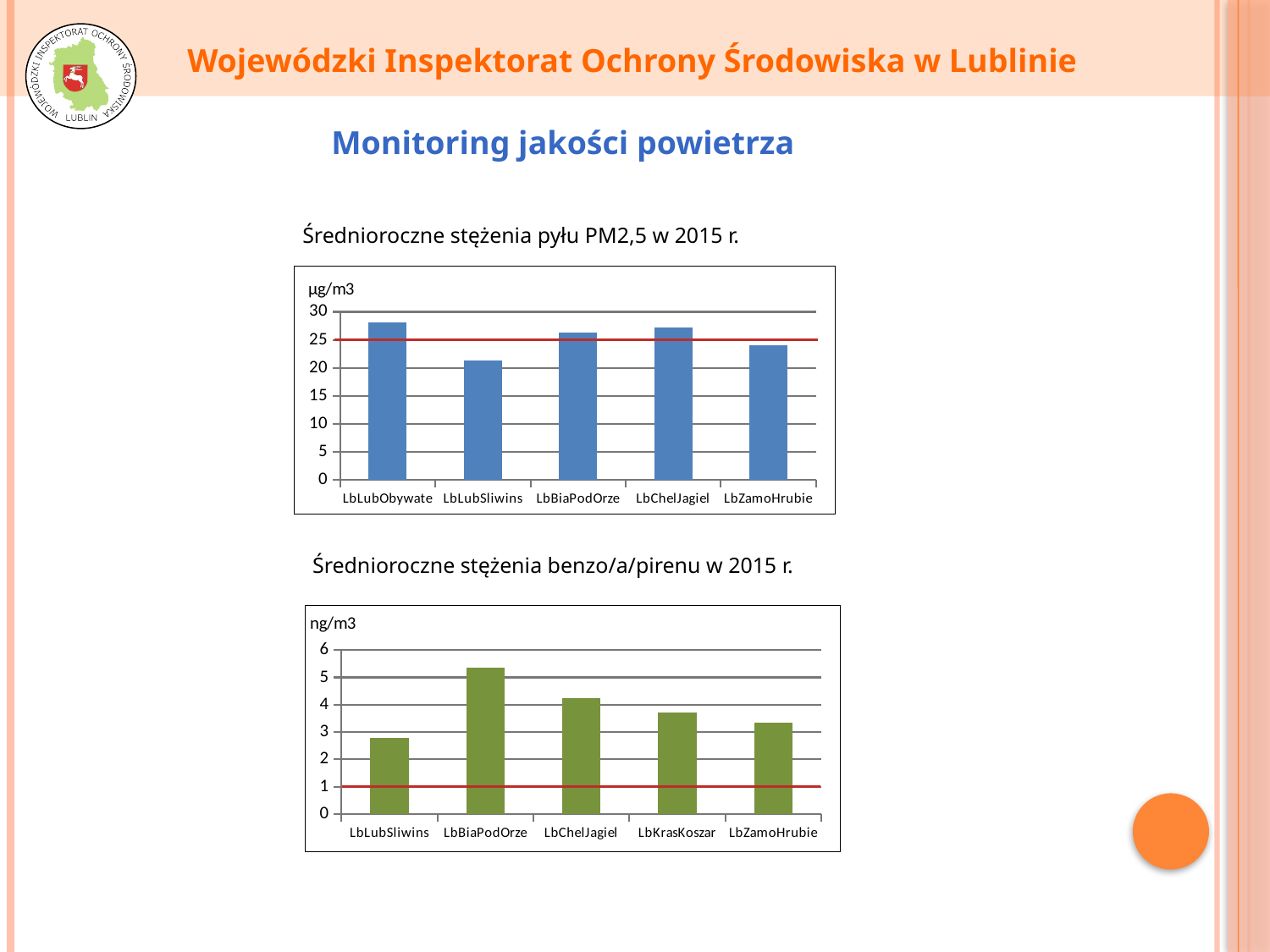
In the chart 'Średnioroczne stężenia pyłu PM2,5 w 2015 r.', which station has the lowest value? LbLubSliwins In the chart 'Średnioroczne stężenia pyłu PM2,5 w 2015 r.', is the value for LbZamoHrubie greater or less than 25? less How many stations are shown in the chart 'Średnioroczne stężenia pyłu PM2,5 w 2015 r.'? 5 In the chart 'Średnioroczne stężenia benzo/a/pirenu w 2015 r.', is the value for LbLubSliwins greater or less than 3? less In the chart 'Średnioroczne stężenia benzo/a/pirenu w 2015 r.', is the value for LbBiaPodOrze greater or less than 5? greater What unit is shown on the y axis of the chart 'Średnioroczne stężenia pyłu PM2,5 w 2015 r.'? µg/m3 In the chart 'Średnioroczne stężenia benzo/a/pirenu w 2015 r.', which station has the highest value? LbBiaPodOrze In the chart 'Średnioroczne stężenia pyłu PM2,5 w 2015 r.', which is larger, the value for LbLubObywate or LbLubSliwins? LbLubObywate What type of chart is 'Średnioroczne stężenia benzo/a/pirenu w 2015 r.'? bar chart In the chart 'Średnioroczne stężenia benzo/a/pirenu w 2015 r.', which station has the lowest value? LbLubSliwins